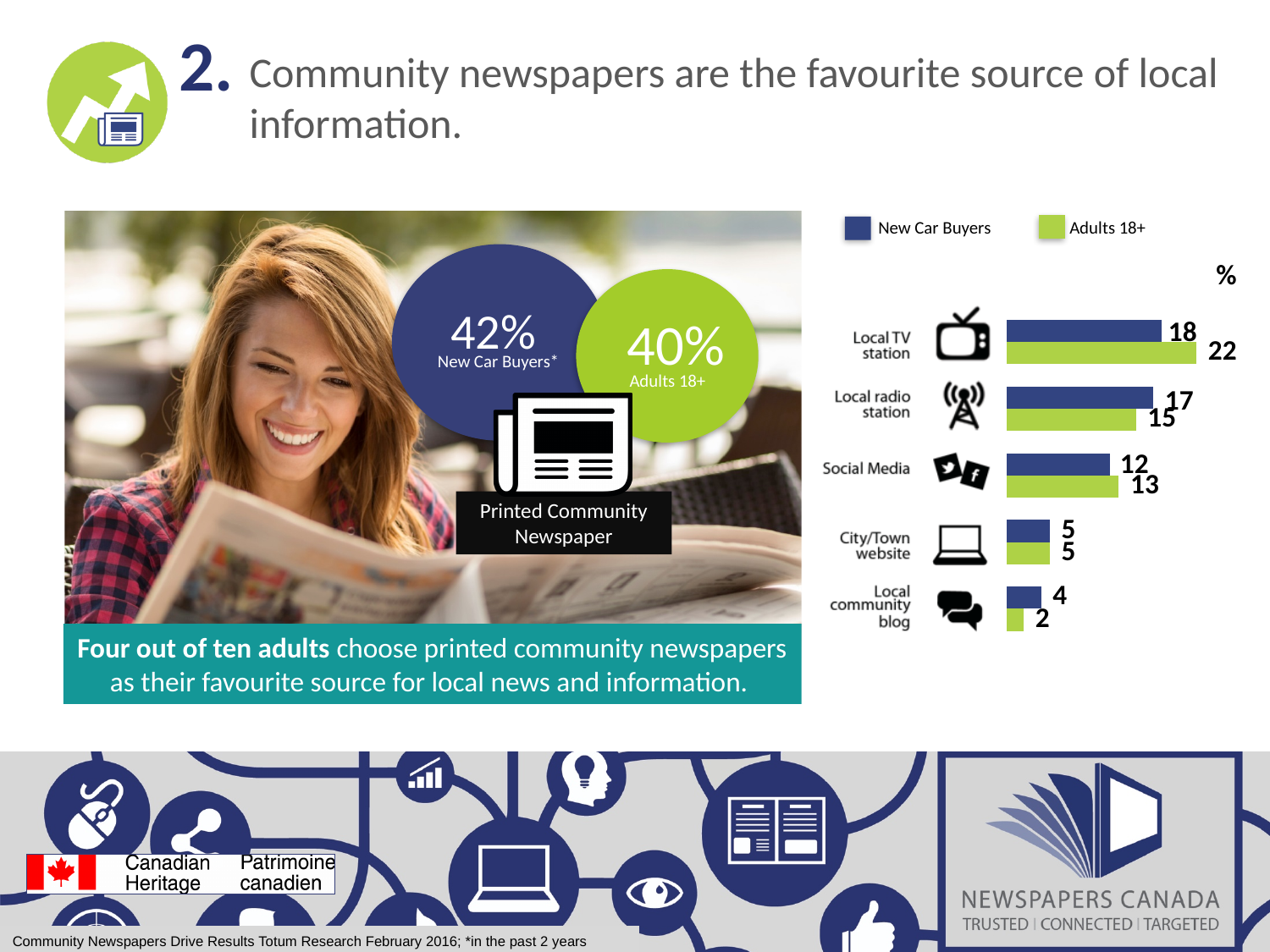
In the bar chart, what is the value for Adults 18+ for Local TV station? 22 How many series does the legend of the bar chart list? 2 In the bar chart, what is the difference between the Adults 18+ and New Car Buyers values for Local TV station? 4 In the bar chart, which category has the lowest value for New Car Buyers? Local community blog What kind of chart is shown on the right side of the slide? bar chart In the bar chart, what is the value for New Car Buyers for City/Town website? 5 In the bar chart, what is the value for New Car Buyers for Local radio station? 17 In the bar chart, which colour represents the Adults 18+ series? green In the bar chart, which category has the highest value for Adults 18+? Local TV station How many categories are shown in the bar chart? 5 In the bar chart, what is the value for Adults 18+ for Local community blog? 2 In the bar chart, which is larger for Social Media: the New Car Buyers value or the Adults 18+ value? Adults 18+